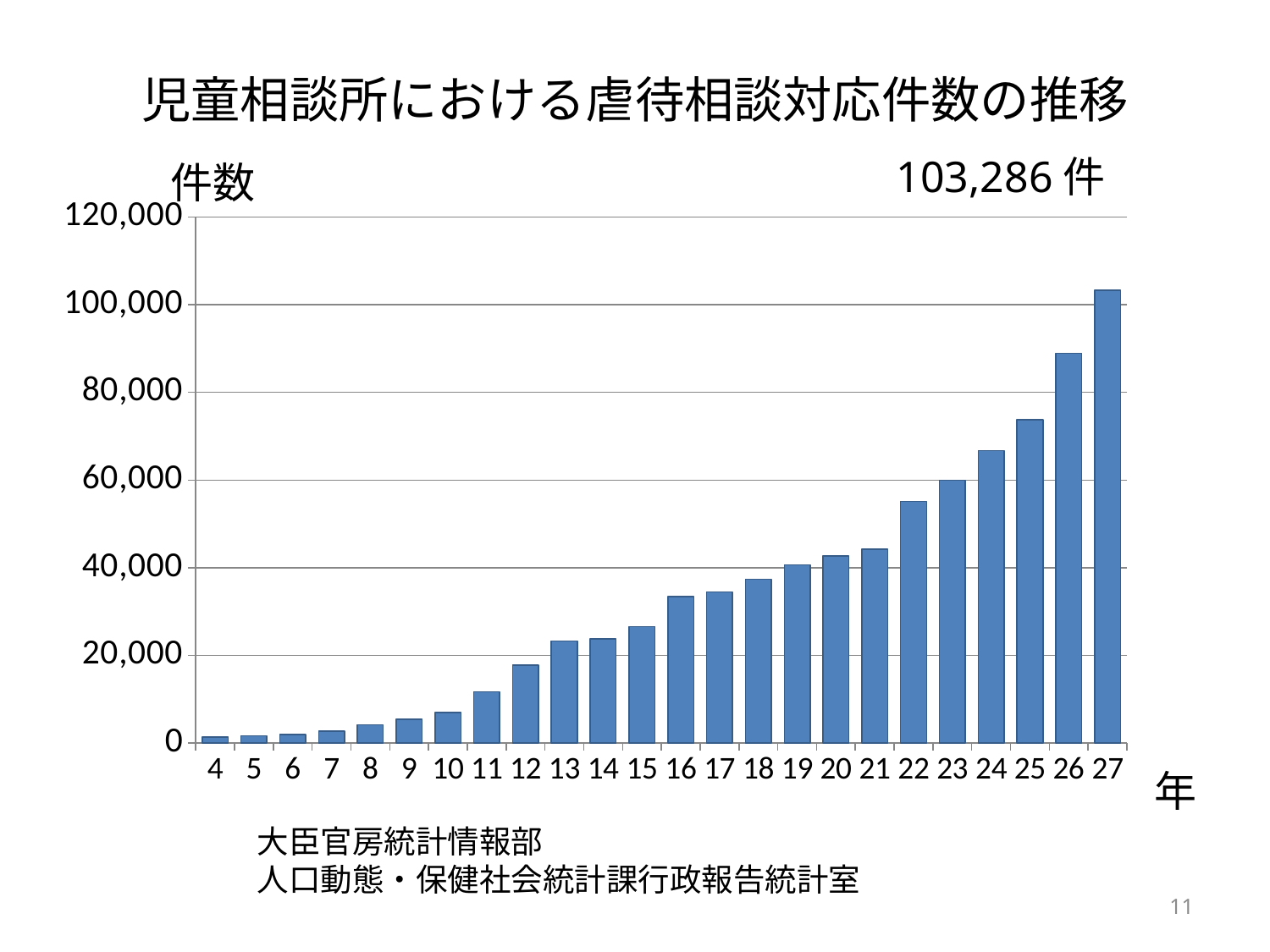
What kind of chart is shown on the slide? bar chart How many years (bars) are plotted on the chart? 24 Which year has the highest number of cases? 27 Is the value for year 16 greater or less than 40,000? less Which is larger, the value for year 10 or the value for year 11? 11 Is the value for year 22 greater or less than 60,000? less Is the value for year 26 greater or less than 80,000? greater Which year has the lowest number of cases? 4 Do the values rise or fall from year 4 to year 27? rise What is the number of cases shown for year 27? 103,286 件 What is the title of the chart? 児童相談所における虐待相談対応件数の推移